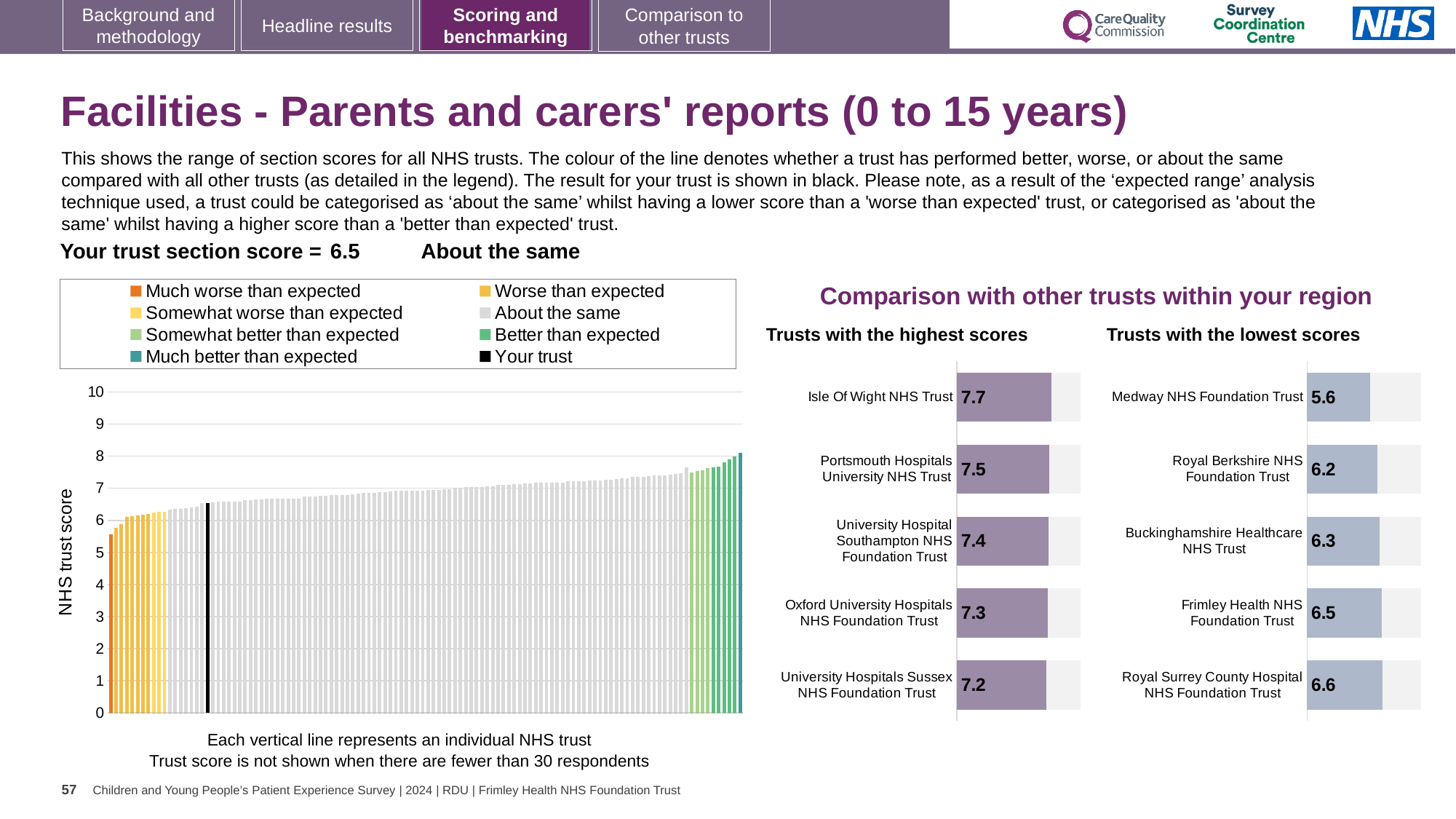
In the 'Trusts with the lowest scores' chart, what is the score for Buckinghamshire Healthcare NHS Trust? 6.3 How many trusts are listed in the 'Trusts with the lowest scores' chart? 5 In the 'Trusts with the highest scores' chart, what is the score for Isle Of Wight NHS Trust? 7.7 In the 'Trusts with the highest scores' chart, which has a higher score: Portsmouth Hospitals University NHS Trust or Oxford University Hospitals NHS Foundation Trust? Portsmouth Hospitals University NHS Trust In the 'Trusts with the highest scores' chart, what is the difference between the scores of Isle Of Wight NHS Trust and University Hospitals Sussex NHS Foundation Trust? 0.5 In the 'Trusts with the lowest scores' chart, which trust has the lowest score? Medway NHS Foundation Trust In the main chart on the left showing all NHS trusts, is the value for the black 'Your trust' bar greater or less than 5? greater In the 'Trusts with the lowest scores' chart, what is the score for Medway NHS Foundation Trust? 5.6 In the 'Trusts with the highest scores' chart, which trust has the highest score? Isle Of Wight NHS Trust What kind of chart is the main chart on the left showing NHS trust scores? bar chart In the 'Trusts with the lowest scores' chart, what is the difference between the scores of Royal Surrey County Hospital NHS Foundation Trust and Medway NHS Foundation Trust? 1.0 How many entries does the legend of the main chart on the left list? 8